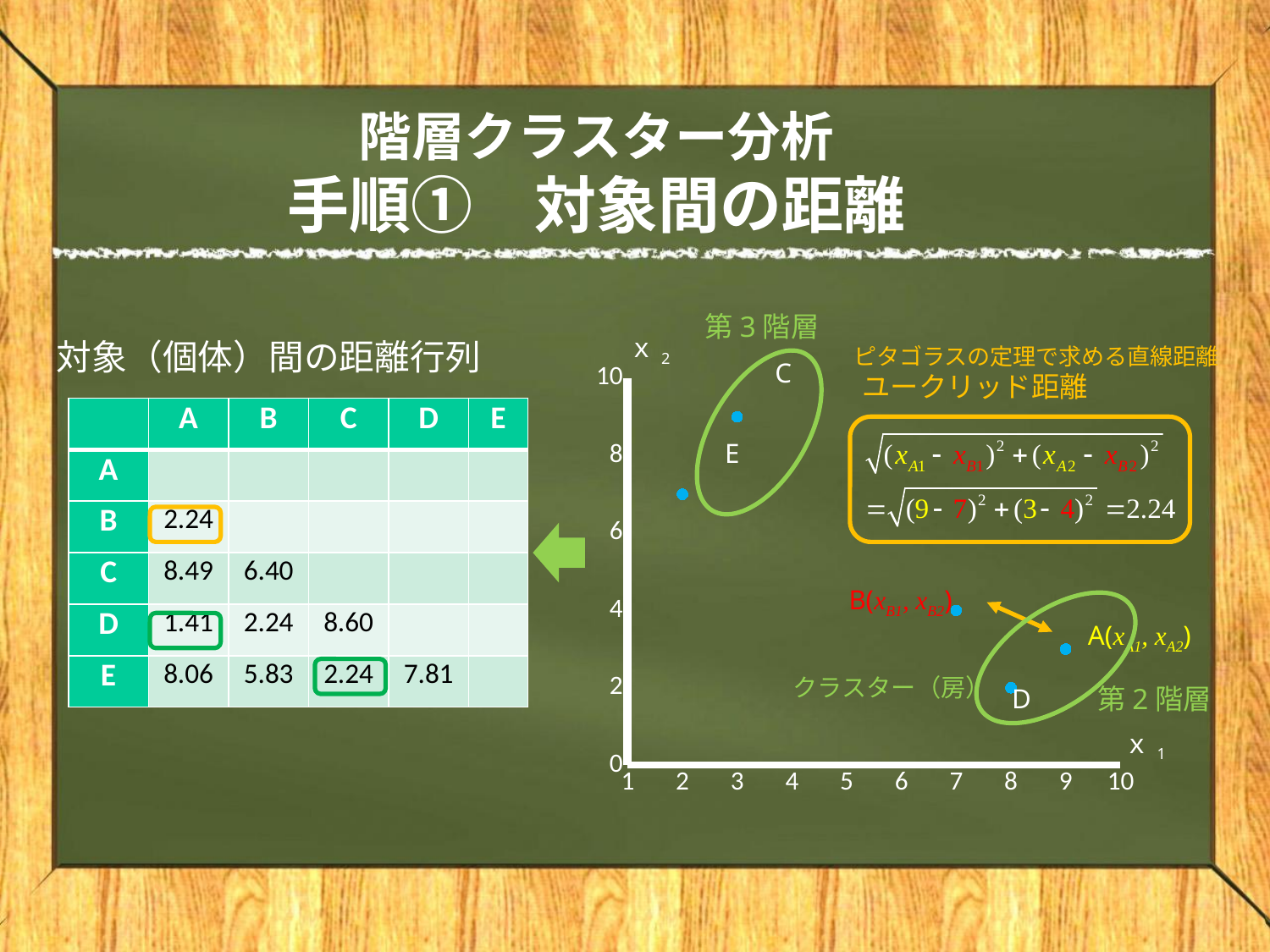
In the scatter chart, which point has the highest x2 value? C In the scatter chart, is the x2 value for point E greater or less than 6? greater How many data points are plotted in the scatter chart? 5 In the scatter chart, which point has the lowest x2 value? D In the scatter chart, is the x2 value for point D greater or less than 4? less In the scatter chart, is the x1 value for point C greater or less than 5? less In the scatter chart, which point has the lowest x1 value? E What kind of chart is shown on the right side of the slide? scatter chart In the scatter chart, which point has the larger x1 value, A or B? A Which two points are circled together as the 第2階層 cluster in the scatter chart? A and D According to the formula on the slide, what is the Euclidean distance between points A and B? 2.24 In the scatter chart, which point has the highest x1 value? A